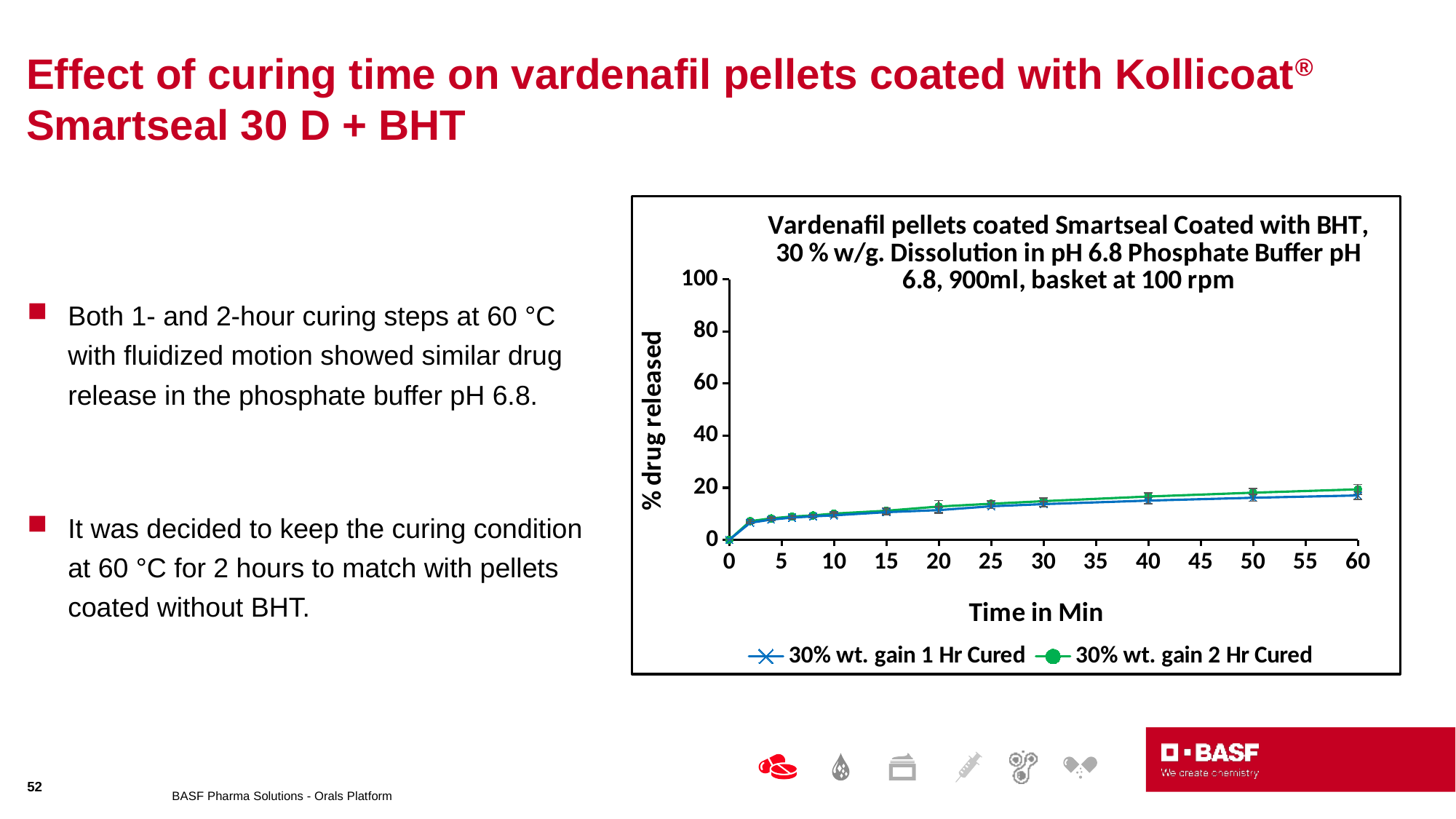
Do the % drug released values rise or fall as time increases along the x axis? Rise What kind of chart is shown on the slide? Line chart What is the % drug released for the 30% wt. gain 2 Hr Cured series at time 0? 0 Is the % drug released for the 30% wt. gain 2 Hr Cured series at 20 minutes greater or less than 0? greater Is the % drug released for the 30% wt. gain 2 Hr Cured series at 10 minutes greater or less than 20? less What is the label of the chart's y axis? % drug released Is the % drug released for the 30% wt. gain 1 Hr Cured series at 30 minutes greater or less than 20? less At which time point on the x axis is the % drug released lowest for the 30% wt. gain 1 Hr Cured series? 0 At which time point on the x axis does the 30% wt. gain 2 Hr Cured series reach its highest % drug released? 60 What are the two series named in the chart legend? 30% wt. gain 1 Hr Cured and 30% wt. gain 2 Hr Cured How many series does the chart legend list? 2